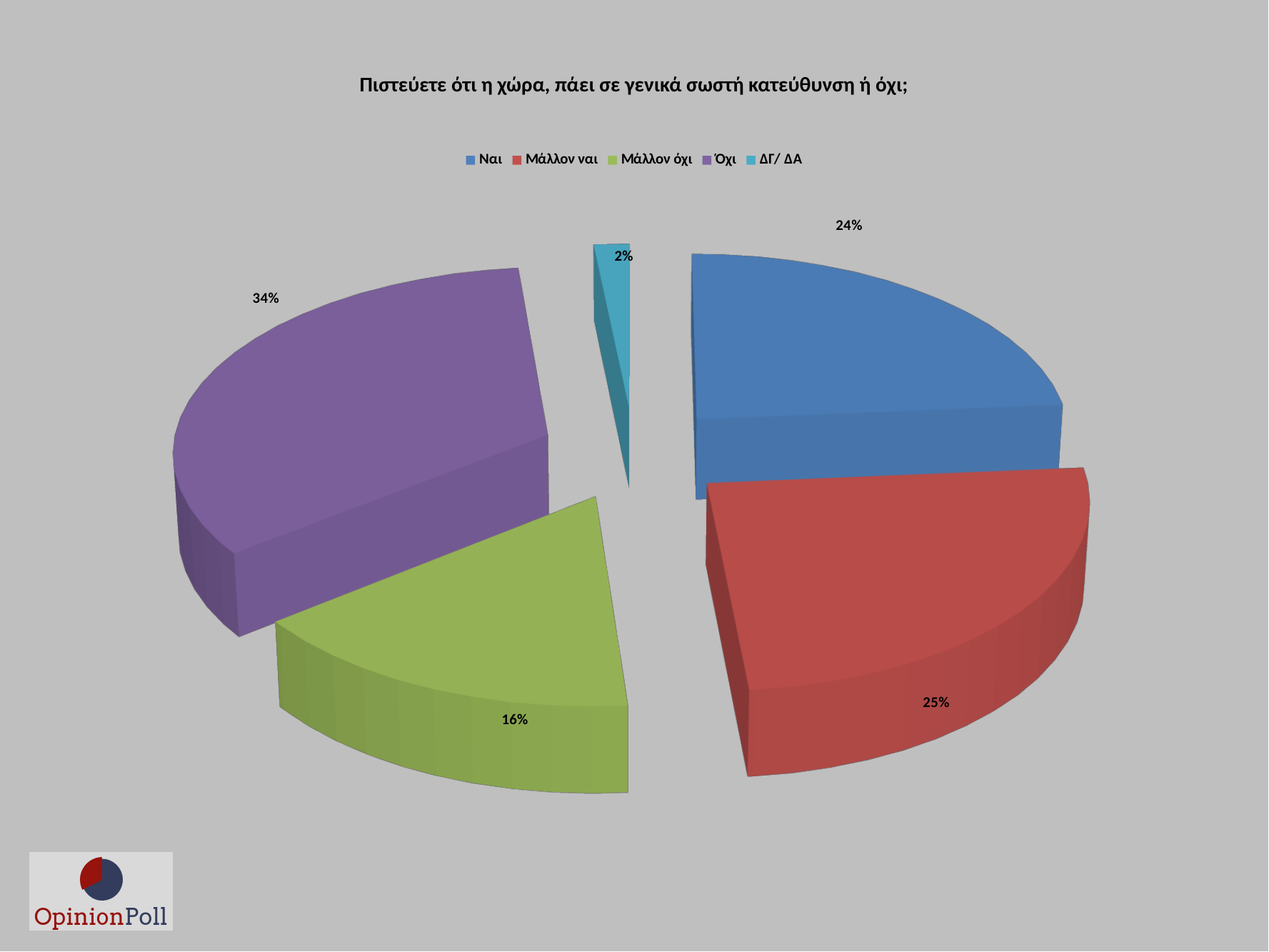
Which response has the largest share of the pie? Όχι What is the difference in percentage points between "Όχι" and "Ναι"? 10 What percentage of respondents answered "Μάλλον ναι"? 25% What percentage of respondents answered "Ναι"? 24% Which is larger, the share for "Μάλλον όχι" or the share for "Μάλλον ναι"? Μάλλον ναι What type of chart is shown on the slide? Pie chart Which response has the smallest share of the pie? ΔΓ/ ΔΑ How many categories does the legend list? 5 What percentage of respondents answered "ΔΓ/ ΔΑ"? 2% What percentage of respondents answered "Μάλλον όχι"? 16% What percentage of respondents answered "Όχι"? 34% Which colour represents "Όχι" in the pie chart? Purple